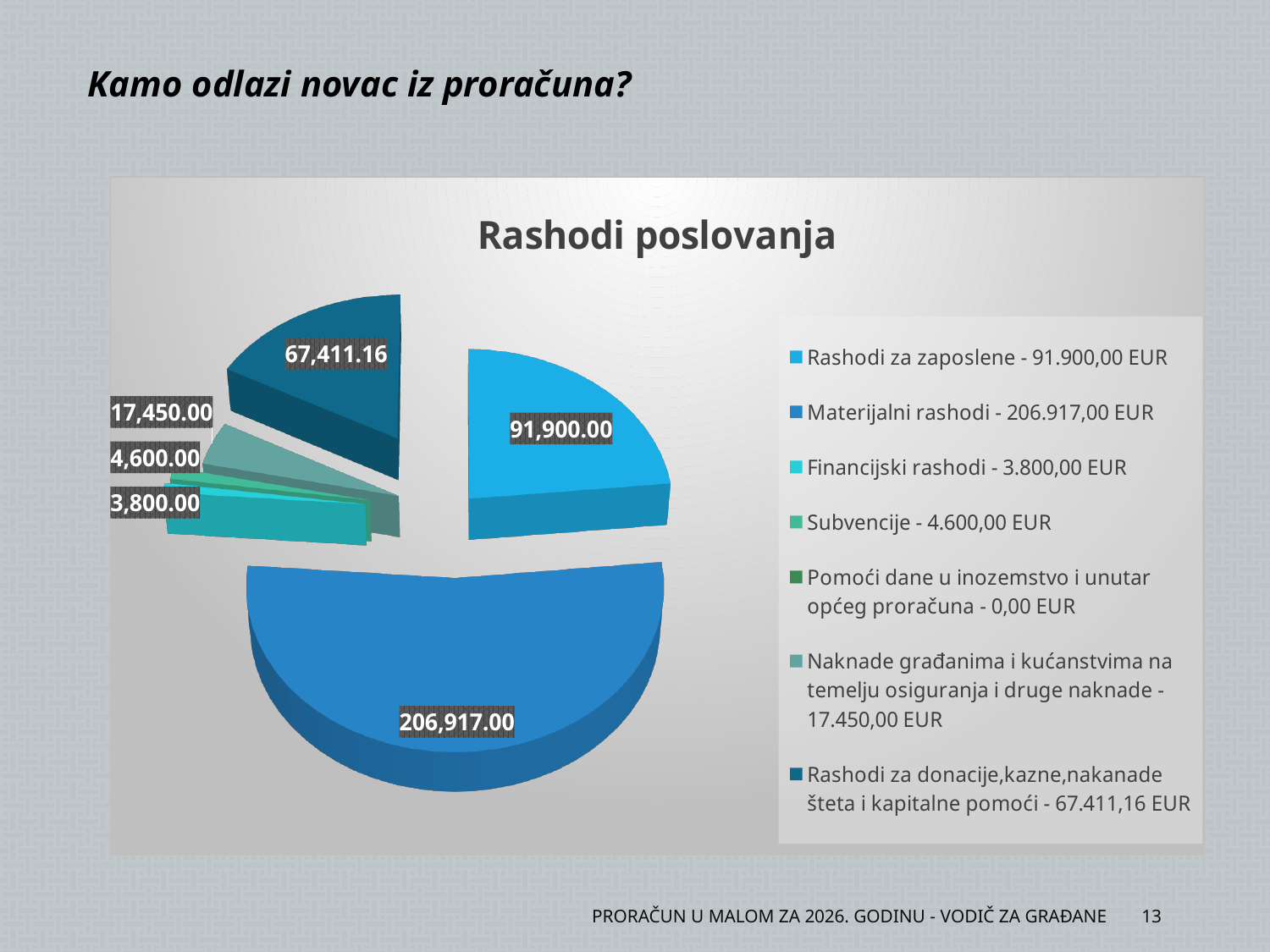
What value is shown on the data label for Rashodi za donacije, kazne, nakanade šteta i kapitalne pomoći? 67,411.16 Which is larger, the value for Subvencije or the value for Financijski rashodi? Subvencije How many categories does the legend list? 7 According to the legend, which category has the lowest value? Pomoći dane u inozemstvo i unutar općeg proračuna What value is shown on the data label for Subvencije? 4,600.00 What kind of chart is shown on the slide? Pie chart How many data series does the chart contain? 1 What is the difference between the values for Materijalni rashodi and Rashodi za zaposlene? 115,017.00 What is the title of the chart? Rashodi poslovanja Which category has the largest slice of the pie? Materijalni rashodi What value is shown on the data label for Materijalni rashodi? 206,917.00 What value is shown on the data label for Rashodi za zaposlene? 91,900.00